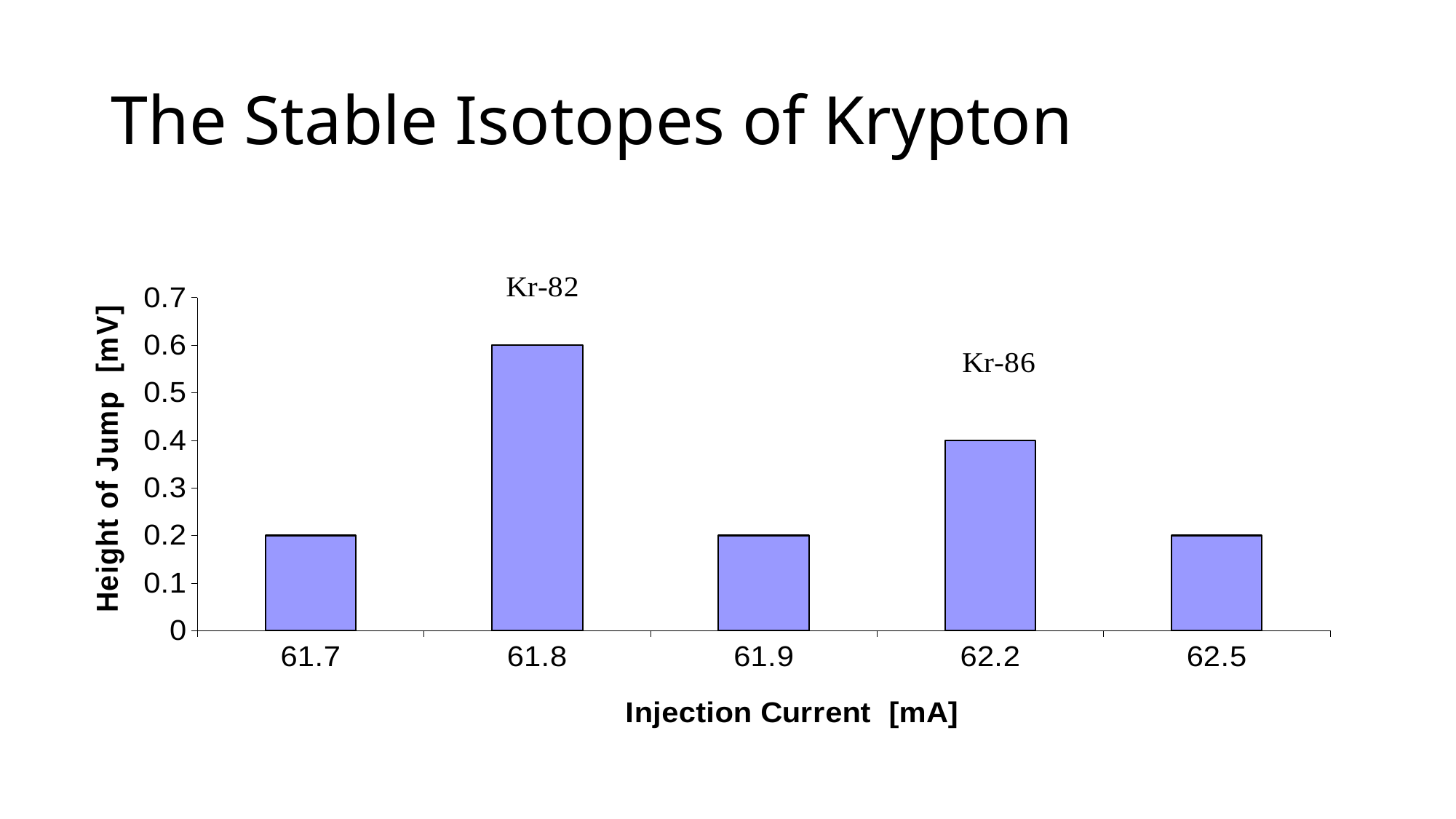
How many injection current values are plotted on the chart? 5 What is the height of jump for an injection current of 61.8 mA? 0.6 Which isotope label is placed above the bar at 61.8 mA? Kr-82 What kind of chart is shown on the slide? bar chart Which has a larger height of jump, 61.9 mA or 62.2 mA? 62.2 What is the difference in height of jump between the 61.8 mA bar and the 62.2 mA bar? 0.2 What is the height of jump for an injection current of 62.2 mA? 0.4 Which injection current has the highest height of jump? 61.8 What is the difference in height of jump between the 61.8 mA bar and the 61.7 mA bar? 0.4 What is the height of jump for an injection current of 61.7 mA? 0.2 Is the height of jump at 62.5 mA greater or less than 0.3? less What is the label of the y axis? Height of Jump [mV]